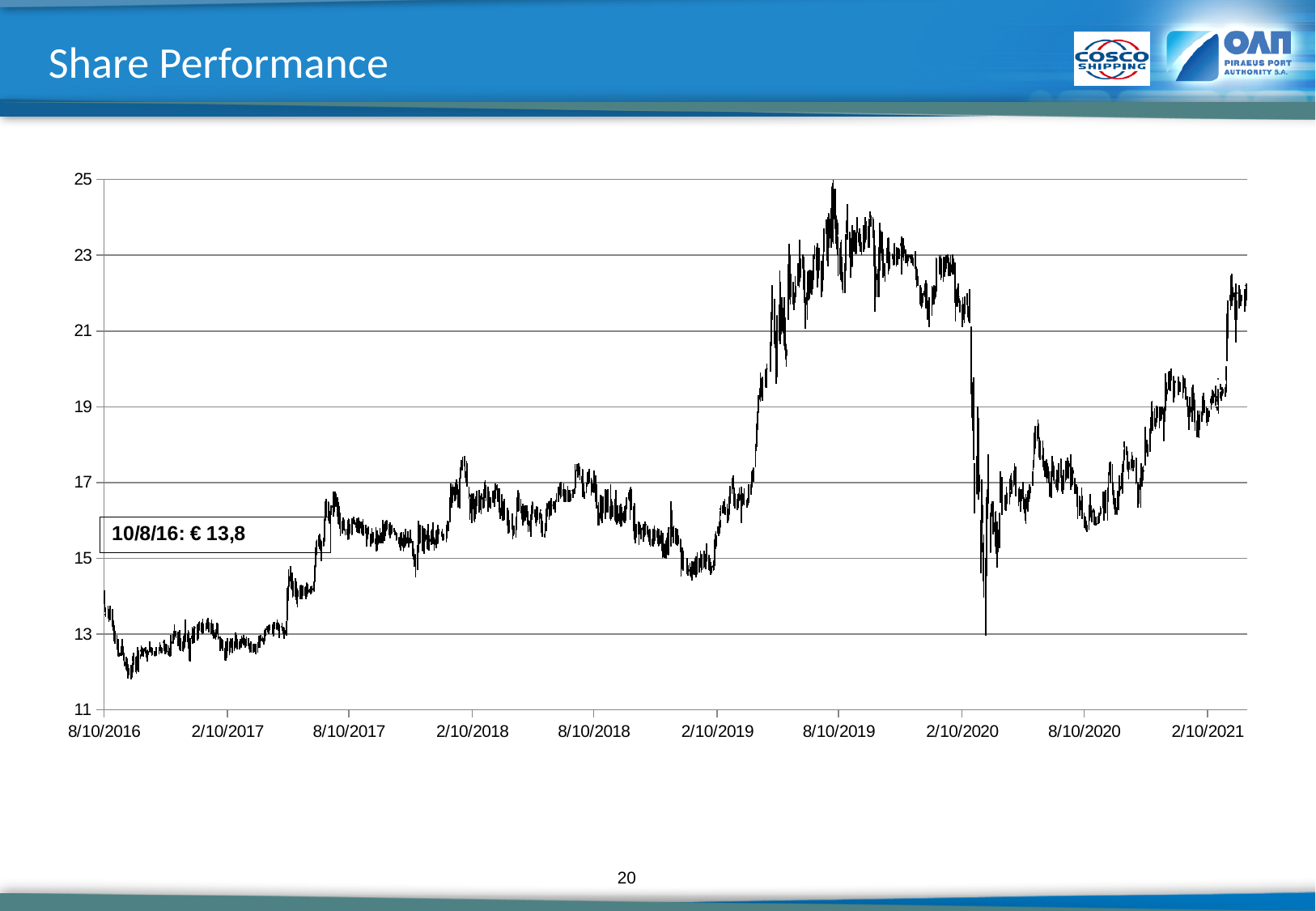
What is the chart's title? Share Performance Do the share price values rise or fall between 2/10/2019 and 8/10/2019? rise How many date labels are shown on the x axis? 10 Is the share price around 8/10/2020 greater or less than 19? less What are the lowest and highest values shown on the y axis? 11 and 25 What kind of chart is shown on the slide? line chart Which is higher, the share price around 8/10/2019 or around 8/10/2020? 8/10/2019 Is the highest point on the chart greater or less than 23? greater According to the annotation on the chart, what was the share price on 10/8/16? € 13,8 Around which x-axis date does the share price reach its highest level? 8/10/2019 Is the share price around 8/10/2017 greater or less than 15? greater